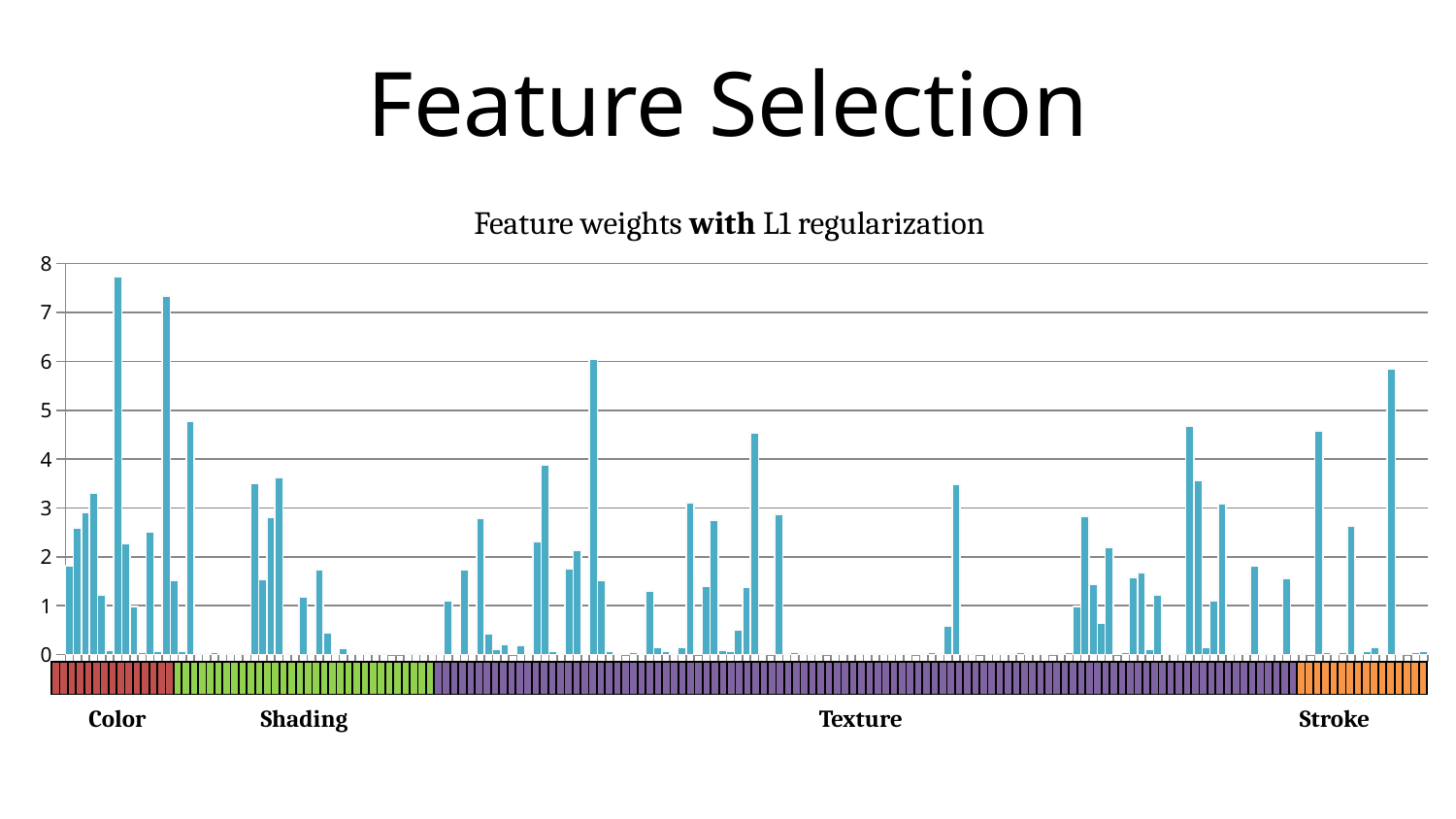
Which feature group spans the most bars along the x axis? Texture What is the highest value shown on the y axis? 8 Which feature group contains the tallest bar in the chart? Color Is the tallest bar in the chart greater or less than 7? greater What is the title of the chart? Feature weights with L1 regularization Is the tallest bar in the Shading group greater or less than 4? greater What kind of chart is shown on the slide? bar chart Is the tallest bar in the Stroke group greater or less than 5? greater Which has the taller tallest bar, the Shading group or the Stroke group? Stroke How many feature groups are labeled along the bottom of the chart? 4